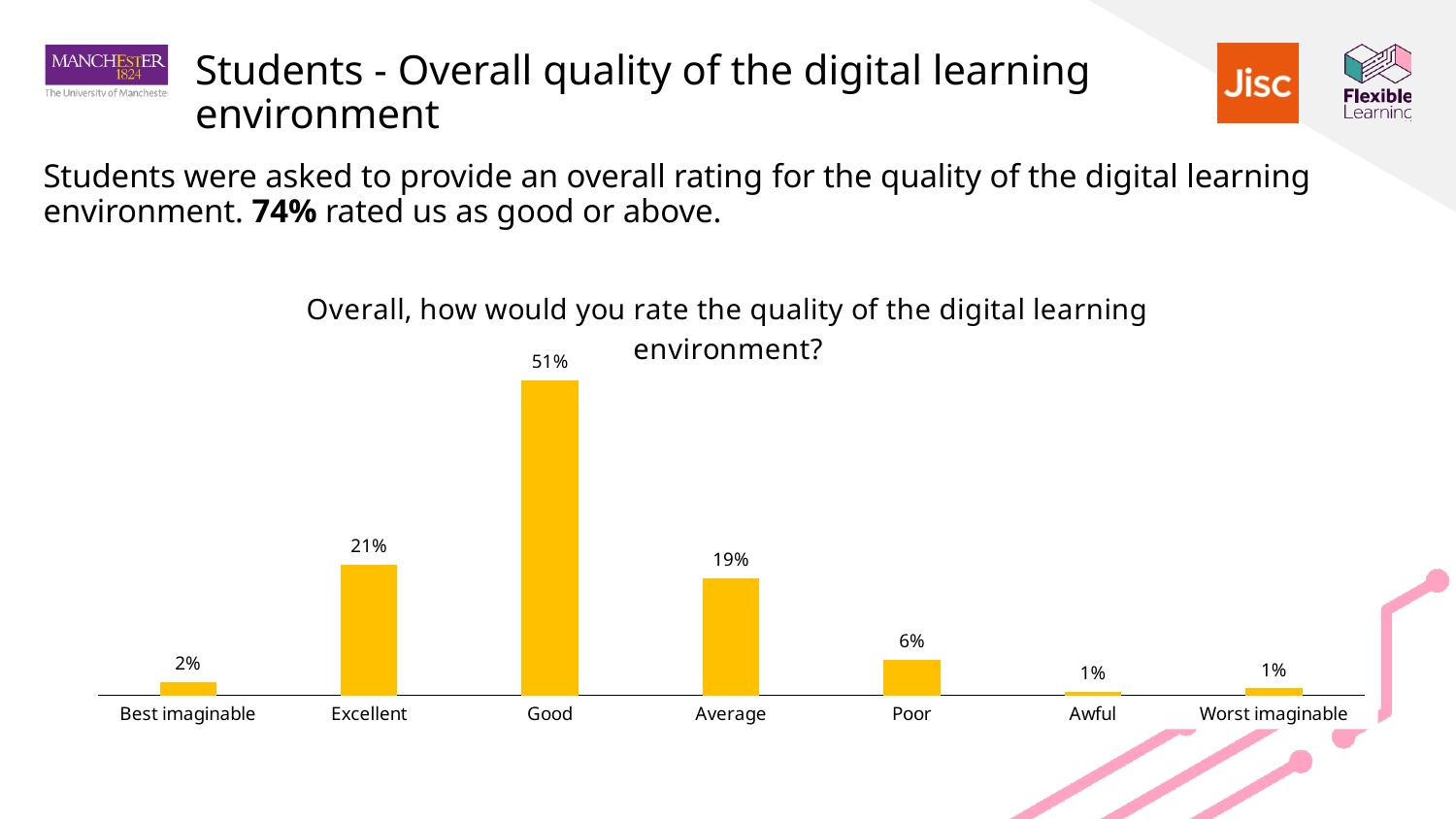
What is the value shown for the Average rating? 19% What percentage of students chose Best imaginable? 2% What type of chart is shown on the slide? Bar chart What is the difference in percentage points between the Good and Excellent ratings? 30 What percentage of students rated the digital learning environment as Excellent? 21% How many rating categories are shown on the x axis? 7 Which rating category has the highest percentage? Good What is the difference between the Average and Poor percentages? 13 What is the combined percentage for Best imaginable, Excellent and Good? 74% What is the title of the chart? Overall, how would you rate the quality of the digital learning environment? Which is larger, the percentage for Excellent or the percentage for Average? Excellent What percentage of students rated the digital learning environment as Good? 51%